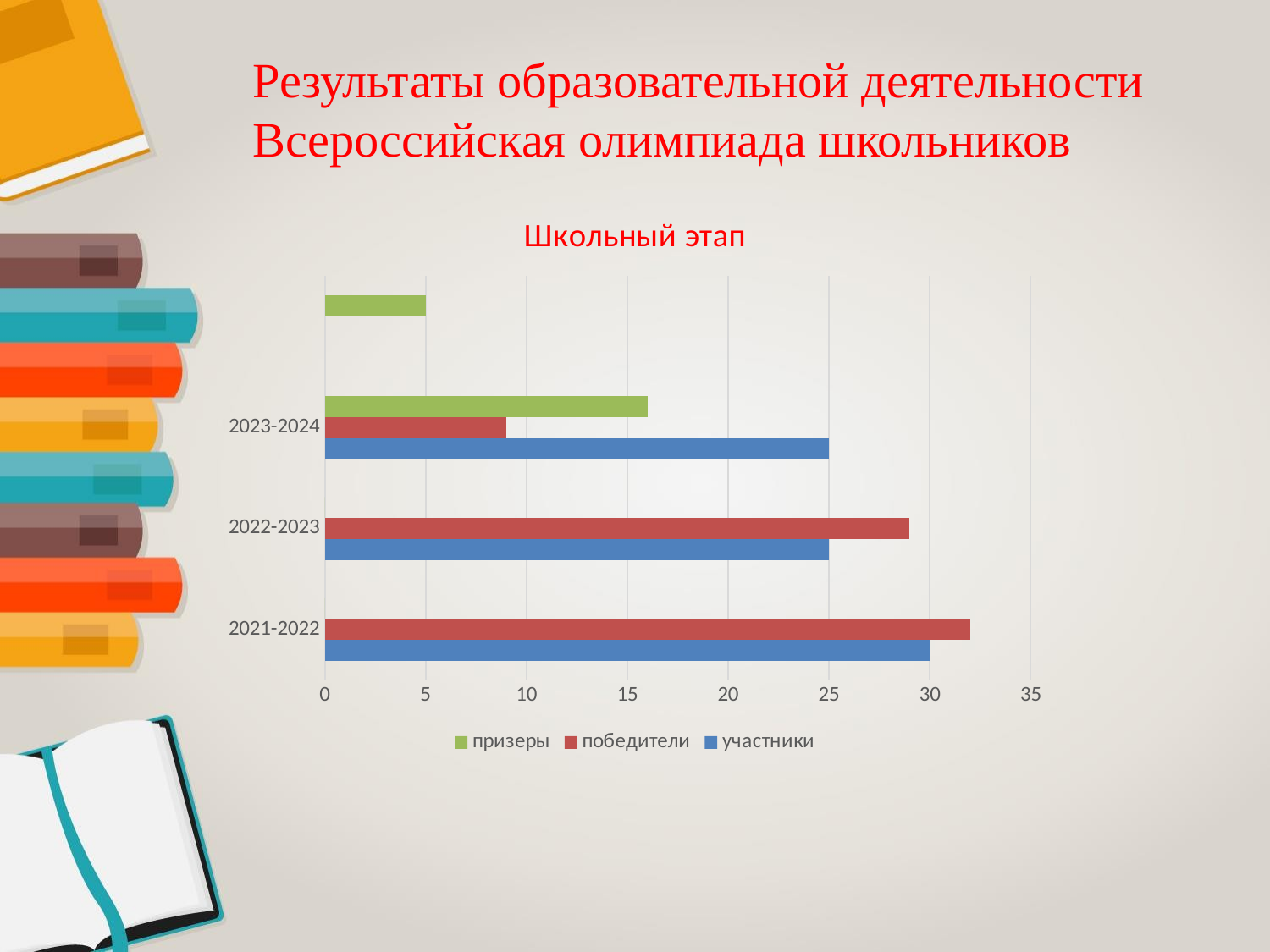
How many series does the legend list? 3 Do the values for победители rise or fall from 2021-2022 to 2023-2024? fall Is the value for призеры in 2023-2024 greater or less than 15? greater Is the value for победители in 2023-2024 greater or less than 10? less What is the value for участники in 2022-2023? 25 What is the value for участники in 2023-2024? 25 In 2021-2022, which is larger: победители or участники? победители In 2023-2024, which is larger: участники or победители? участники Is the value for победители in 2021-2022 greater or less than 30? greater Which year has the highest value for участники? 2021-2022 What is the value for участники in 2021-2022? 30 What kind of chart is shown on the slide? bar chart